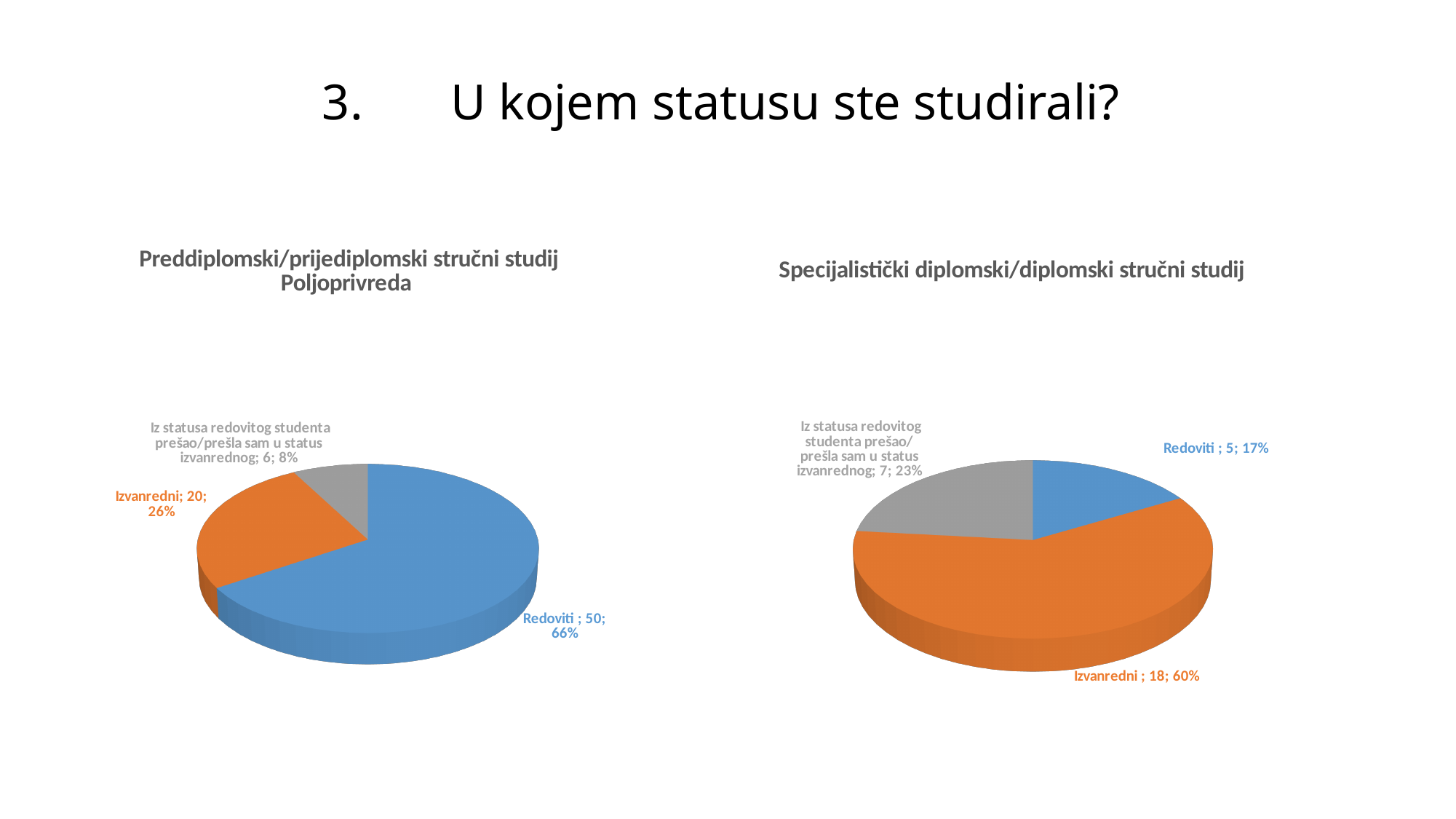
In the right chart (Specijalistički diplomski/diplomski stručni studij), which category has the largest slice? Izvanredni In the left chart (Preddiplomski/prijediplomski stručni studij Poljoprivreda), what is the value for Redoviti? 50 What type of chart is used on this slide? Pie chart In the right chart (Specijalistički diplomski/diplomski stručni studij), what percentage share does Redoviti have? 17% In the left chart (Preddiplomski/prijediplomski stručni studij Poljoprivreda), which category has the smallest slice? Iz statusa redovitog studenta prešao/prešla sam u status izvanrednog In the left chart (Preddiplomski/prijediplomski stručni studij Poljoprivreda), what is the difference between the Redoviti and Izvanredni values? 30 In the right chart (Specijalistički diplomski/diplomski stručni studij), which is larger: the value for Redoviti or the value for the category that switched from full-time to part-time status (Iz statusa redovitog studenta prešao/prešla sam u status izvanrednog)? Iz statusa redovitog studenta prešao/prešla sam u status izvanrednog In the left chart (Preddiplomski/prijediplomski stručni studij Poljoprivreda), how many slices does the pie have? 3 What is the title of the chart on the right side of the slide? Specijalistički diplomski/diplomski stručni studij In the right chart (Specijalistički diplomski/diplomski stručni studij), what is the value for Izvanredni? 18 In the left chart (Preddiplomski/prijediplomski stručni studij Poljoprivreda), what percentage share does Izvanredni have? 26% In the right chart (Specijalistički diplomski/diplomski stručni studij), what is the total of all three slice values? 30